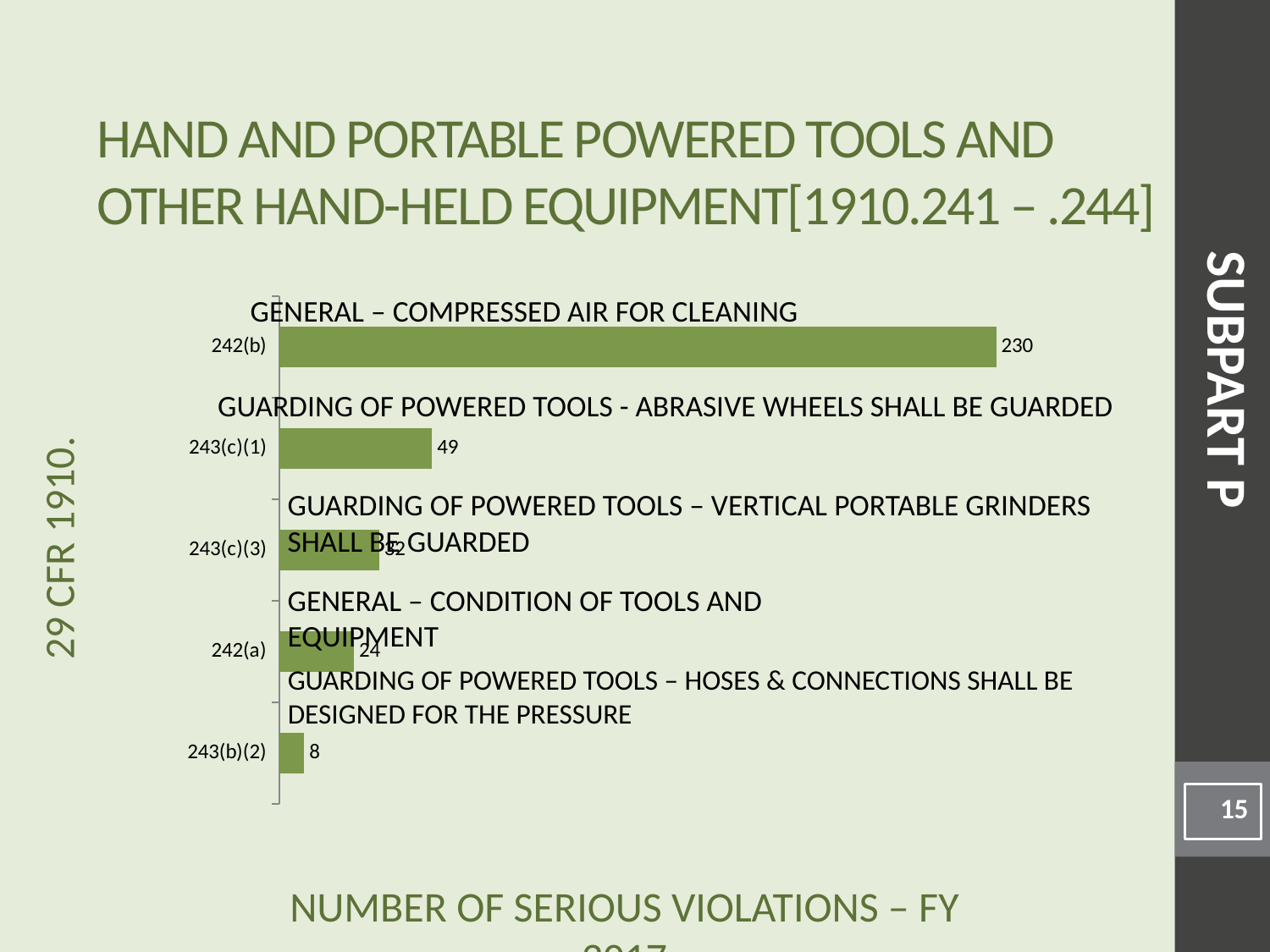
What type of chart is shown on the slide? Bar chart What is the number of serious violations for 243(c)(1)? 49 How many standards (bars) are shown in the chart? 5 What is the difference between the violations for 243(c)(1) and 242(a)? 25 What is the number of serious violations for 243(b)(2)? 8 What is the number of serious violations for 242(b)? 230 Which has more serious violations, 243(c)(1) or 242(a)? 243(c)(1) What is the number of serious violations for 242(a)? 24 Which standard has the lowest number of serious violations? 243(b)(2) Which standard has the highest number of serious violations? 242(b) What is the difference between the violations for 242(b) and 243(c)(1)? 181 What description is given for standard 242(b) in the chart? GENERAL – COMPRESSED AIR FOR CLEANING